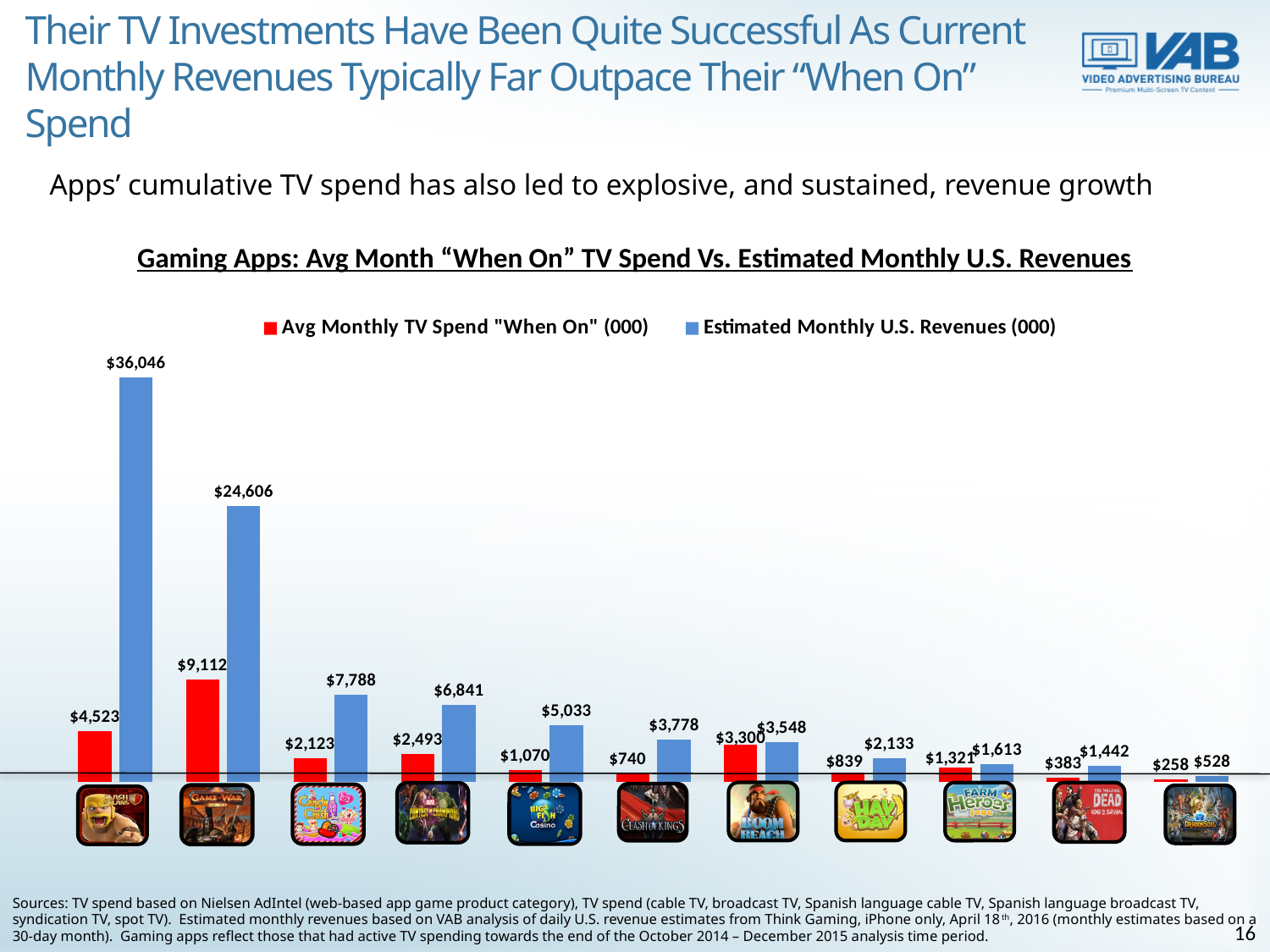
What is the Estimated Monthly U.S. Revenues (000) value for the first (leftmost) app in the chart? $36,046 What is the Avg Monthly TV Spend "When On" (000) value for Boom Beach? $3,300 What colour represents the Estimated Monthly U.S. Revenues (000) series? Blue How many apps (categories) are shown in the chart? 11 How many series does the chart legend list? 2 What is the difference between Estimated Monthly U.S. Revenues and Avg Monthly TV Spend for the leftmost app? $31,523 What type of chart is shown on the slide? Bar chart What is the Estimated Monthly U.S. Revenues (000) value for Hay Day? $2,133 For Clash of Kings, which is larger: the Avg Monthly TV Spend or the Estimated Monthly U.S. Revenues? Estimated Monthly U.S. Revenues ($3,778) What is the Avg Monthly TV Spend "When On" (000) value for the second app from the left? $9,112 Which app has the highest Estimated Monthly U.S. Revenues (000)? The first (leftmost) app, Clash of Clans, at $36,046 Which app has the lowest Avg Monthly TV Spend "When On" (000)? The last (rightmost) app, at $258